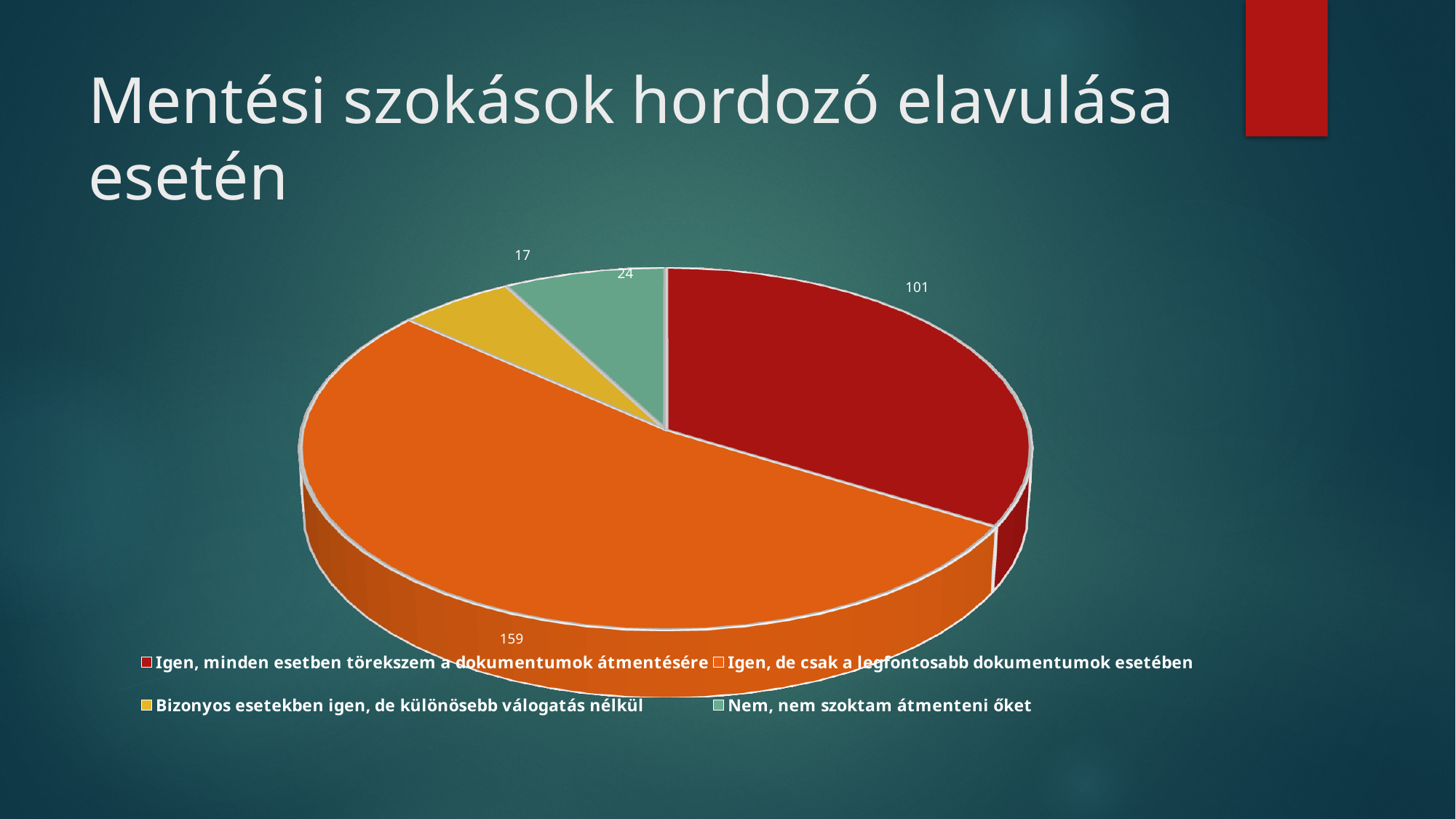
What is the value for "Igen, de csak a legfontosabb dokumentumok esetében"? 159 Which is larger: the value for "Nem, nem szoktam átmenteni őket" or for "Bizonyos esetekben igen, de különösebb válogatás nélkül"? Nem, nem szoktam átmenteni őket What is the value for "Bizonyos esetekben igen, de különösebb válogatás nélkül"? 17 What is the value for "Igen, minden esetben törekszem a dokumentumok átmentésére"? 101 Which category has the smallest slice? Bizonyos esetekben igen, de különösebb válogatás nélkül What kind of chart is shown on the slide? Pie chart Which category has the largest slice? Igen, de csak a legfontosabb dokumentumok esetében What is the difference between the values for "Igen, de csak a legfontosabb dokumentumok esetében" and "Igen, minden esetben törekszem a dokumentumok átmentésére"? 58 What is the value for "Nem, nem szoktam átmenteni őket"? 24 What is the title of the slide containing the chart? Mentési szokások hordozó elavulása esetén What is the total of all slices in the pie chart? 301 How many categories does the pie chart have? 4